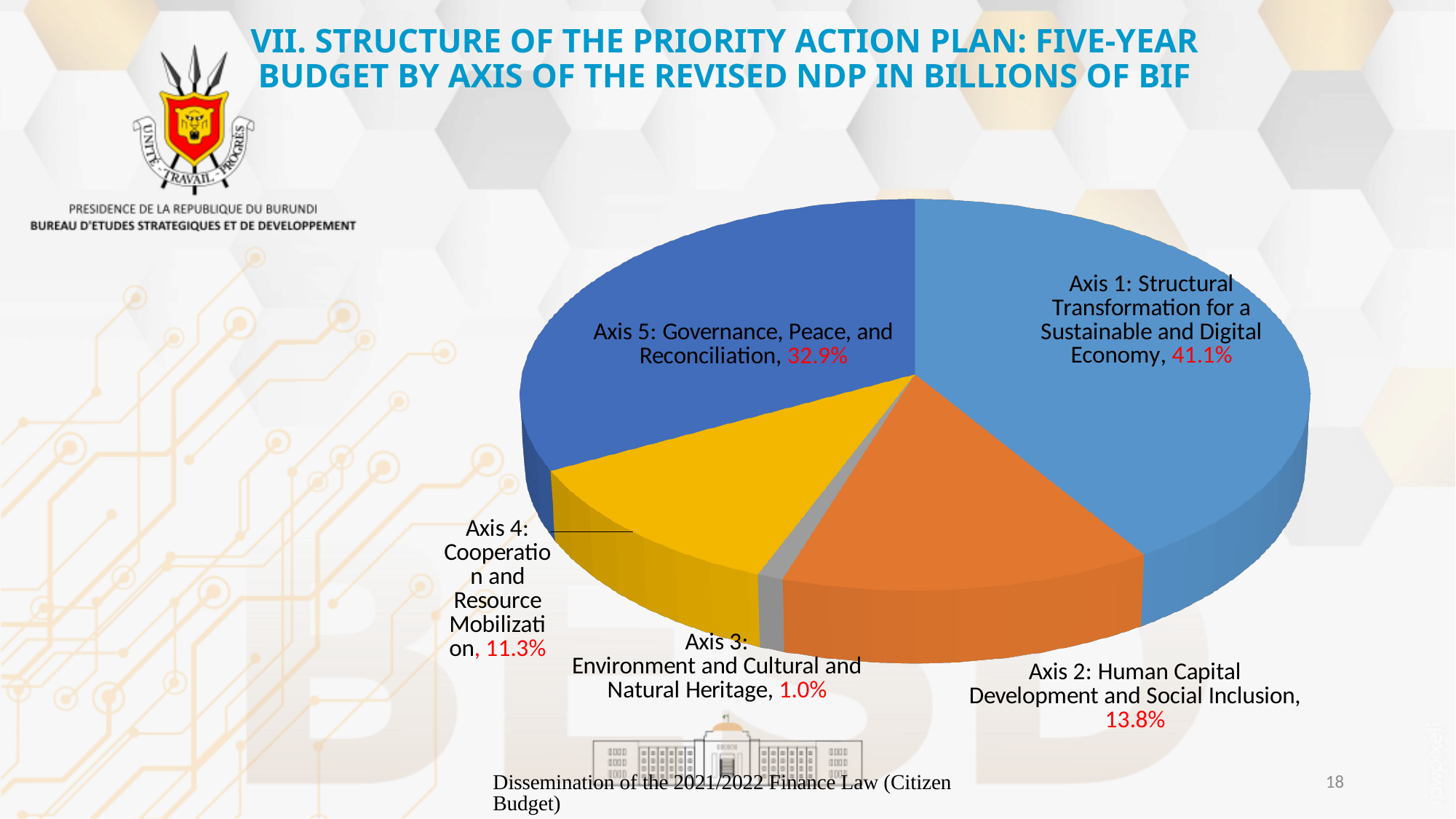
Which axis has the smallest share of the five-year budget? Axis 3: Environment and Cultural and Natural Heritage What share of the five-year budget goes to Axis 4: Cooperation and Resource Mobilization? 11.3% What type of chart is shown on the slide? Pie chart What share of the five-year budget goes to Axis 5: Governance, Peace, and Reconciliation? 32.9% Which has a larger share of the budget, Axis 2 or Axis 4? Axis 2 How many axes are shown in the pie chart? 5 What share of the five-year budget goes to Axis 2: Human Capital Development and Social Inclusion? 13.8% Which axis has the largest share of the five-year budget? Axis 1: Structural Transformation for a Sustainable and Digital Economy What colour is the slice for Axis 4: Cooperation and Resource Mobilization? Yellow What share of the five-year budget goes to Axis 3: Environment and Cultural and Natural Heritage? 1.0% What is the difference in percentage points between the shares of Axis 1 and Axis 5? 8.2 What share of the five-year budget goes to Axis 1: Structural Transformation for a Sustainable and Digital Economy? 41.1%